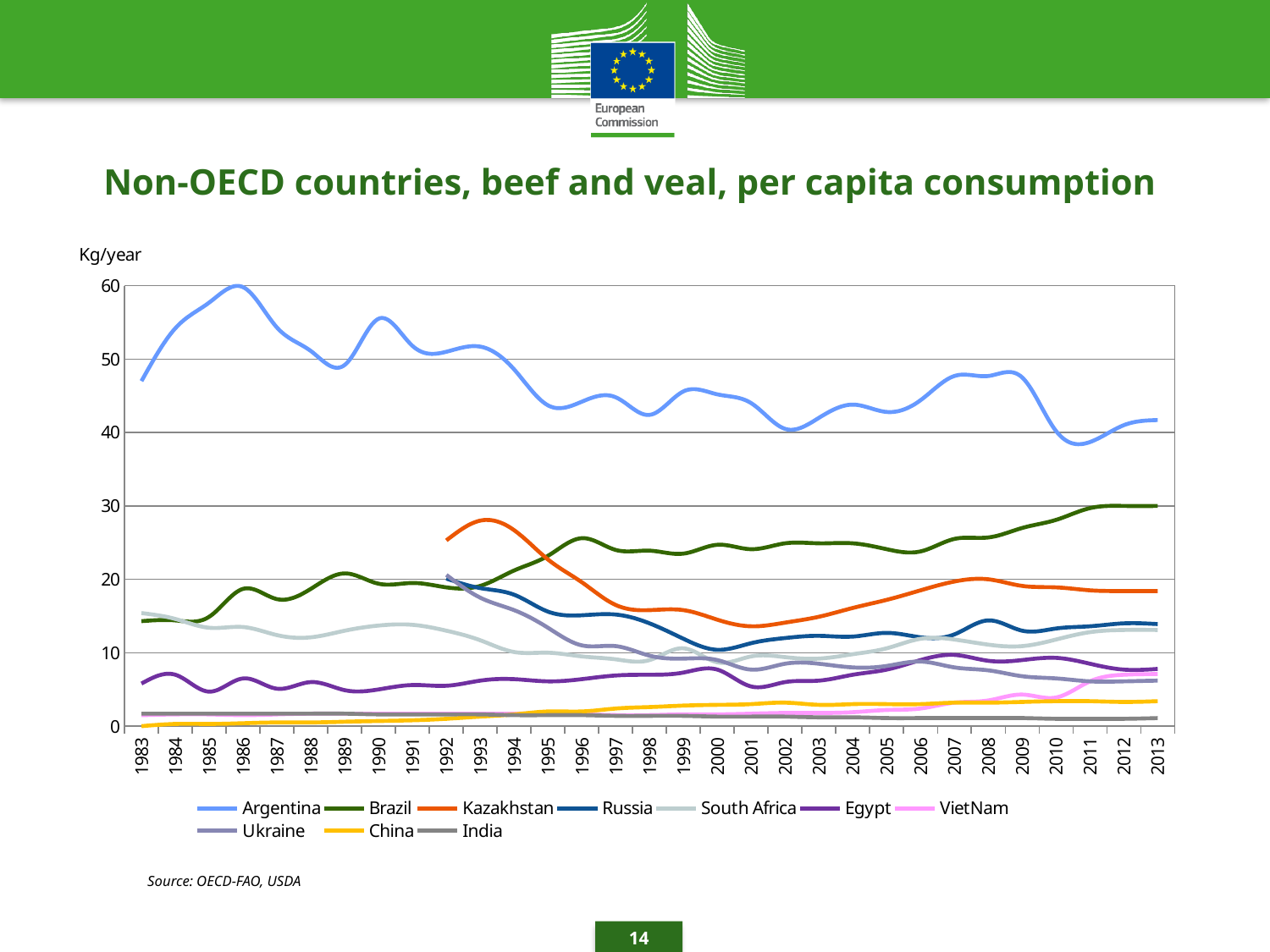
In 2013, which is larger: the value for Russia or the value for Egypt? Russia In which year does Argentina's consumption reach its peak? 1986 What type of chart is shown on the slide? line chart Is the value for Brazil in 2013 greater or less than 20? greater In 2013, which is larger: the value for Brazil or the value for Kazakhstan? Brazil How many years are shown along the x axis? 31 Which country has the highest per capita beef and veal consumption in 2013? Argentina Is the value for Argentina in 1986 greater or less than 50? greater Which country has the lowest per capita beef and veal consumption in 2013? India Does Brazil's consumption rise or fall between 2006 and 2013? rise Is the value for Kazakhstan in 1993 greater or less than 20? greater How many countries (series) does the legend list? 10